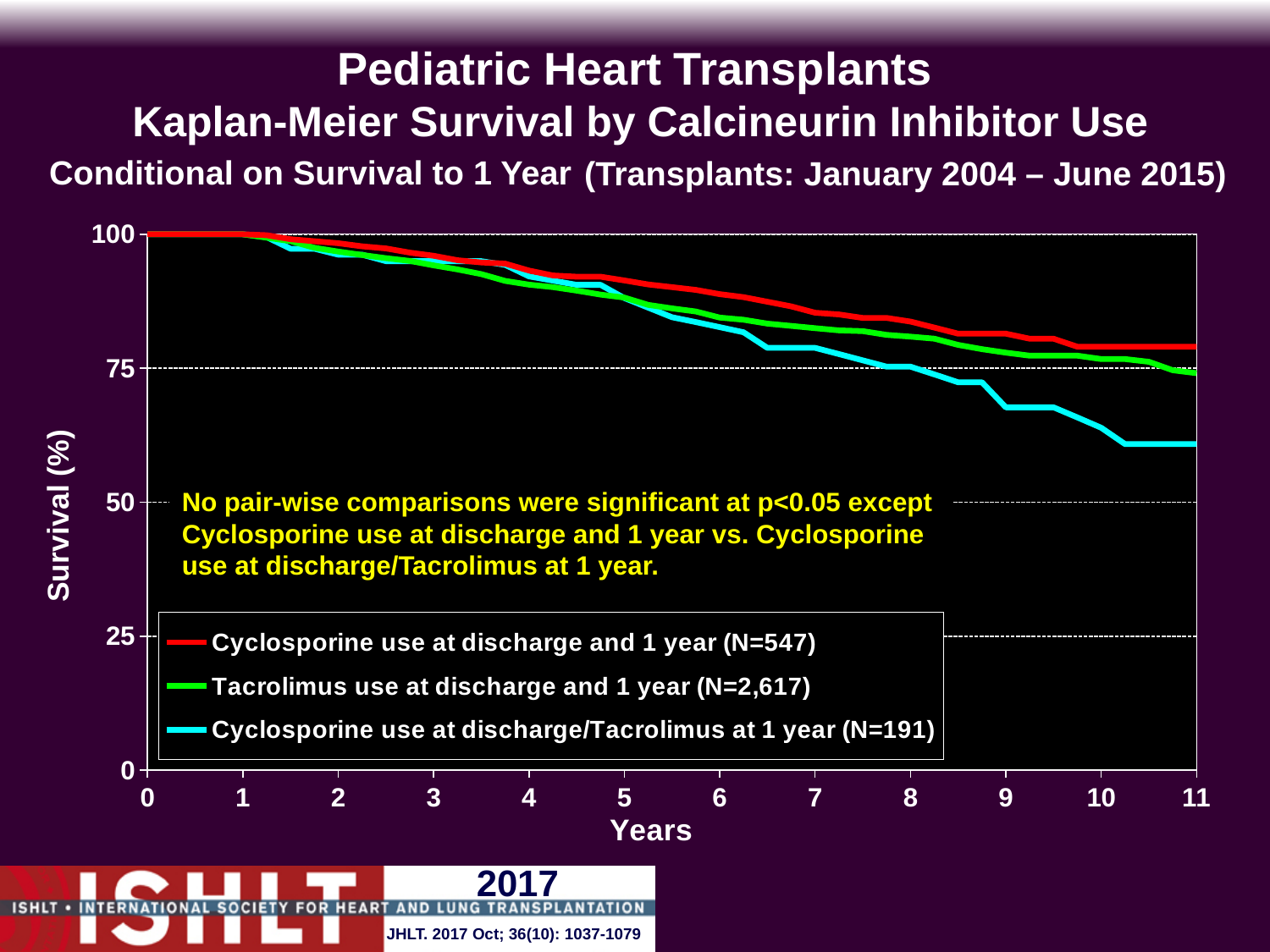
Do the survival curves rise or fall as the years increase? Fall Is the survival value for Cyclosporine use at discharge and 1 year at 11 years greater or less than 75? greater Which series has the highest survival at 11 years? Cyclosporine use at discharge and 1 year What is the N for the Tacrolimus use at discharge and 1 year group shown in the legend? N=2,617 At 11 years, which is larger: survival for Cyclosporine use at discharge and 1 year or for Cyclosporine use at discharge/Tacrolimus at 1 year? Cyclosporine use at discharge and 1 year Is the survival value for Tacrolimus use at discharge and 1 year at 5 years greater or less than 75? greater Which series has the lowest survival at 11 years? Cyclosporine use at discharge/Tacrolimus at 1 year What kind of chart is shown on the slide? Line chart Is the survival value for Cyclosporine use at discharge/Tacrolimus at 1 year at 10 years greater or less than 50? greater How many series does the legend list? 3 What is the label on the y-axis? Survival (%)